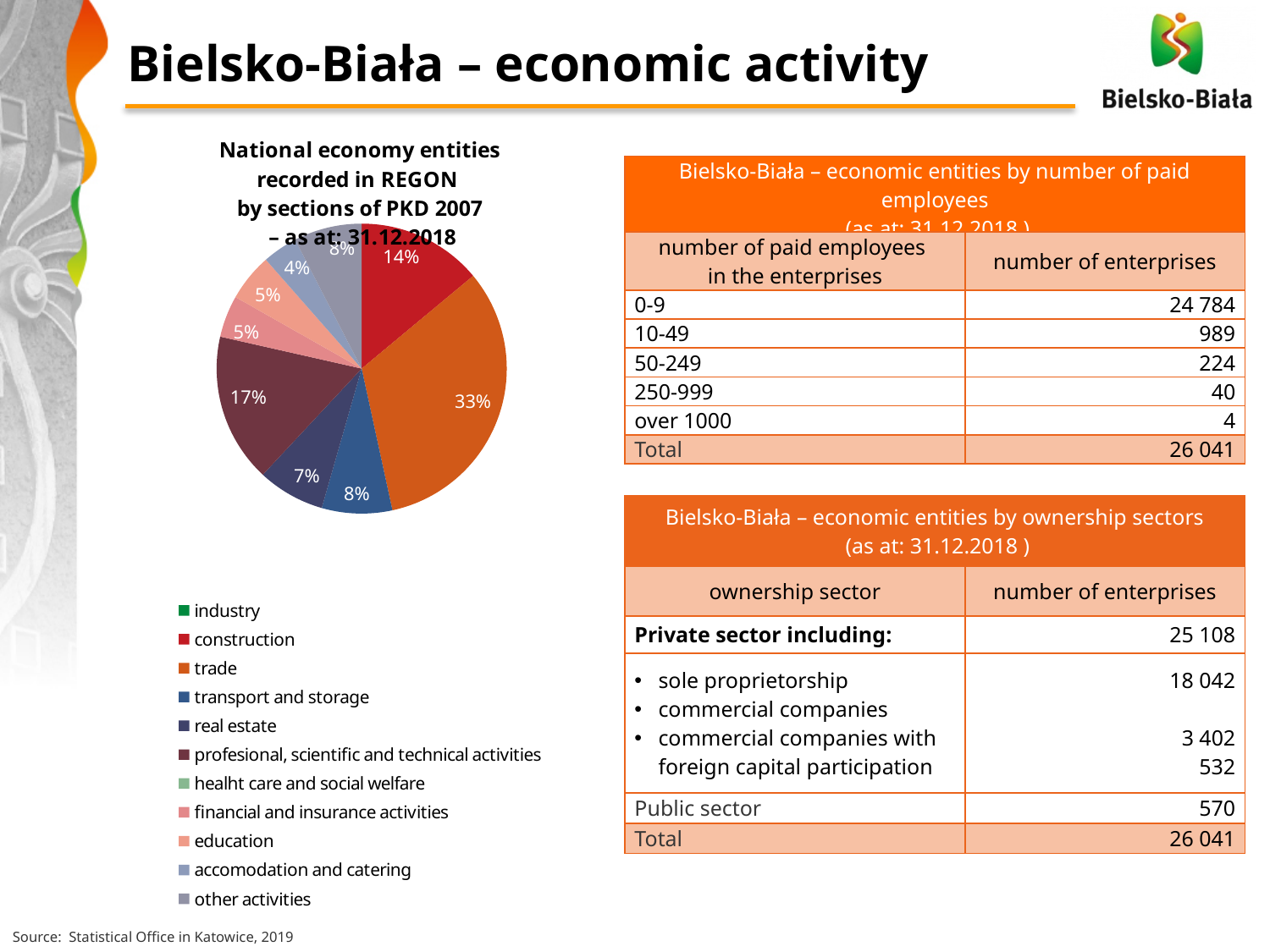
As at what date are the data in the pie chart reported? 31.12.2018 What is the difference in percentage points between trade and profesional, scientific and technical activities in the pie chart? 16 percentage points Which is larger in the pie chart: trade or profesional, scientific and technical activities? trade Which section has the largest share in the pie chart? trade What is the value shown for transport and storage in the pie chart? 8% What is the value shown for other activities in the pie chart? 8% What is the value shown for profesional, scientific and technical activities in the pie chart? 17% What is the value shown for real estate in the pie chart? 7% What is the value shown for accomodation and catering in the pie chart? 4% What share of the pie chart does trade account for? 33% How many categories does the pie chart legend list? 11 What kind of chart is shown on the slide? pie chart